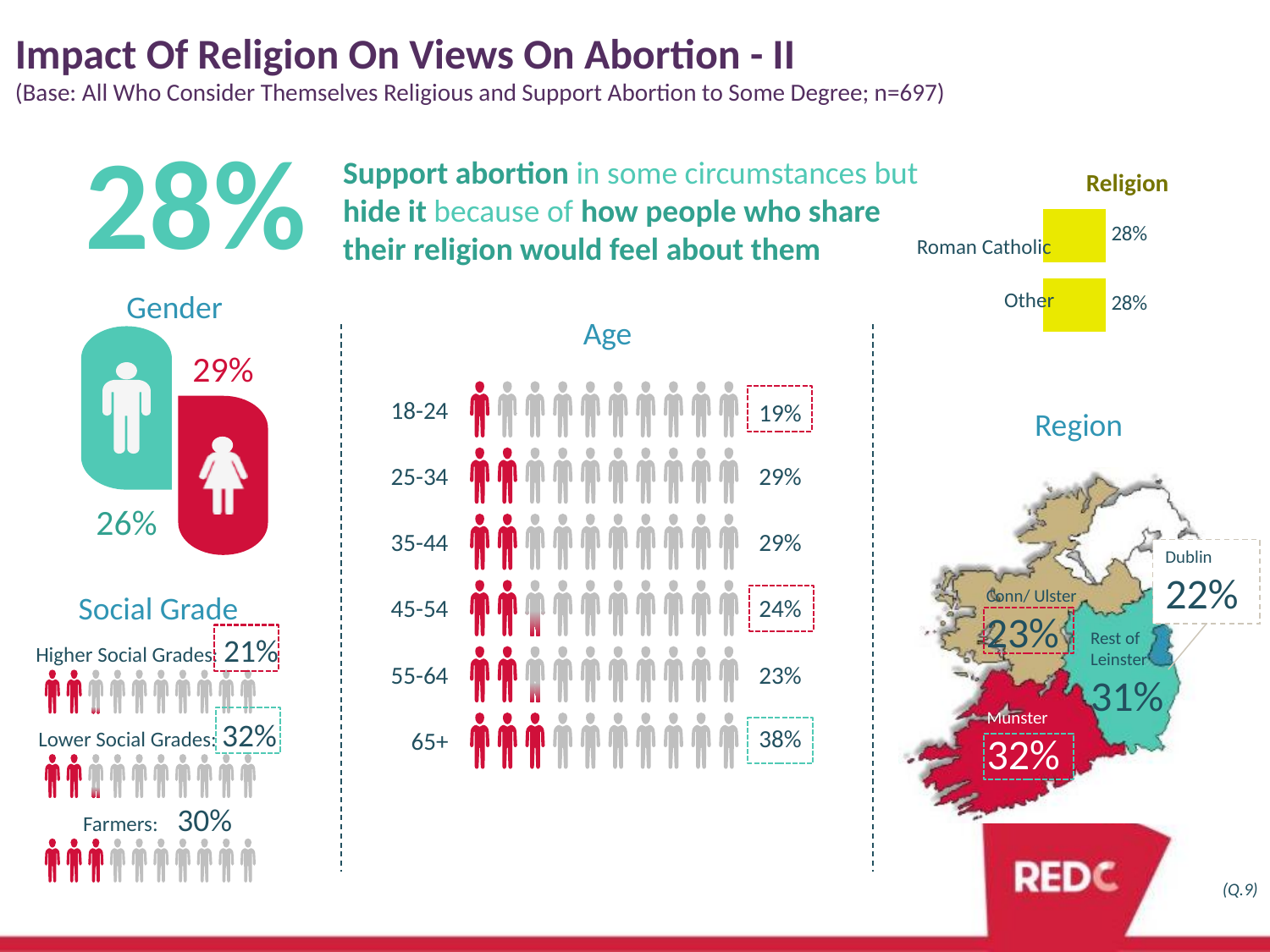
In the Social Grade chart, what is the difference between Lower Social Grades and Higher Social Grades? 11% In the Age chart, which age group has the highest value? 65+ In the Religion chart, what is the value for Roman Catholic? 28% In the Age chart, what is the value for the 65+ age group? 38% In the Gender chart, what is the value for men? 29% In the Region map, what is the value for Munster? 32% In the Region map, which region has the lowest value? Dublin In the Age chart, which age group has the lowest value? 18-24 In the Age chart, how many age groups are shown? 6 In the Gender chart, which is larger, the value for men or the value for women? men In the Social Grade chart, what is the value for Lower Social Grades? 32% In the Age chart, what is the difference between the values for 65+ and 18-24? 19%